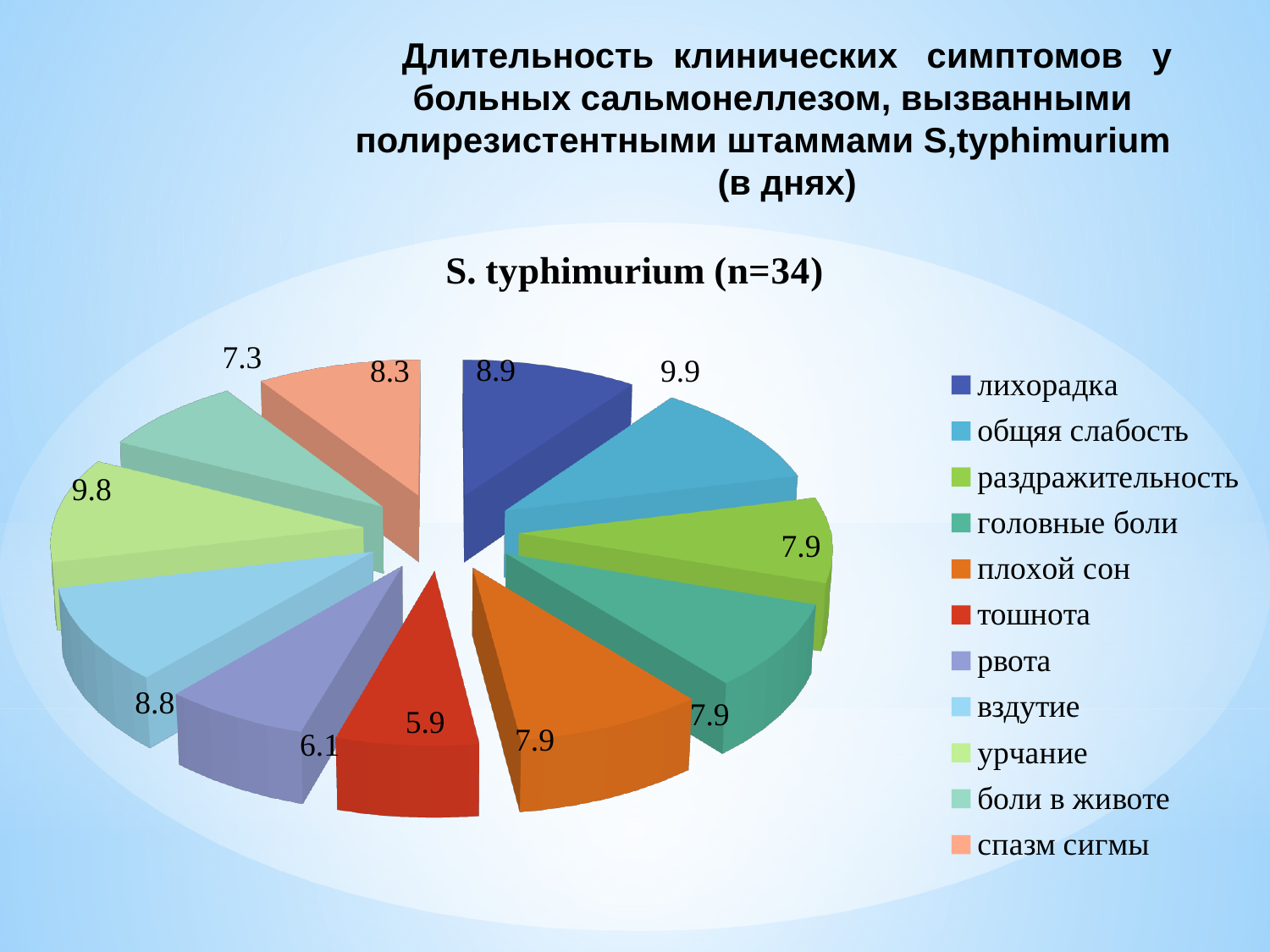
What is the difference between the values for общая слабость and тошнота? 4.0 How many slices does the pie chart have? 11 What is the value for тошнота? 5.9 What is the value for спазм сигмы? 8.3 What type of chart is shown on the slide? pie chart What is the value for урчание? 9.8 Which symptom has the highest value? общая слабость Which is larger, the value for вздутие or the value for рвота? вздутие What is the value for общая слабость? 9.9 What is the value for лихорадка? 8.9 Which symptom has the lowest value? тошнота What is the title of the chart? S. typhimurium (n=34)